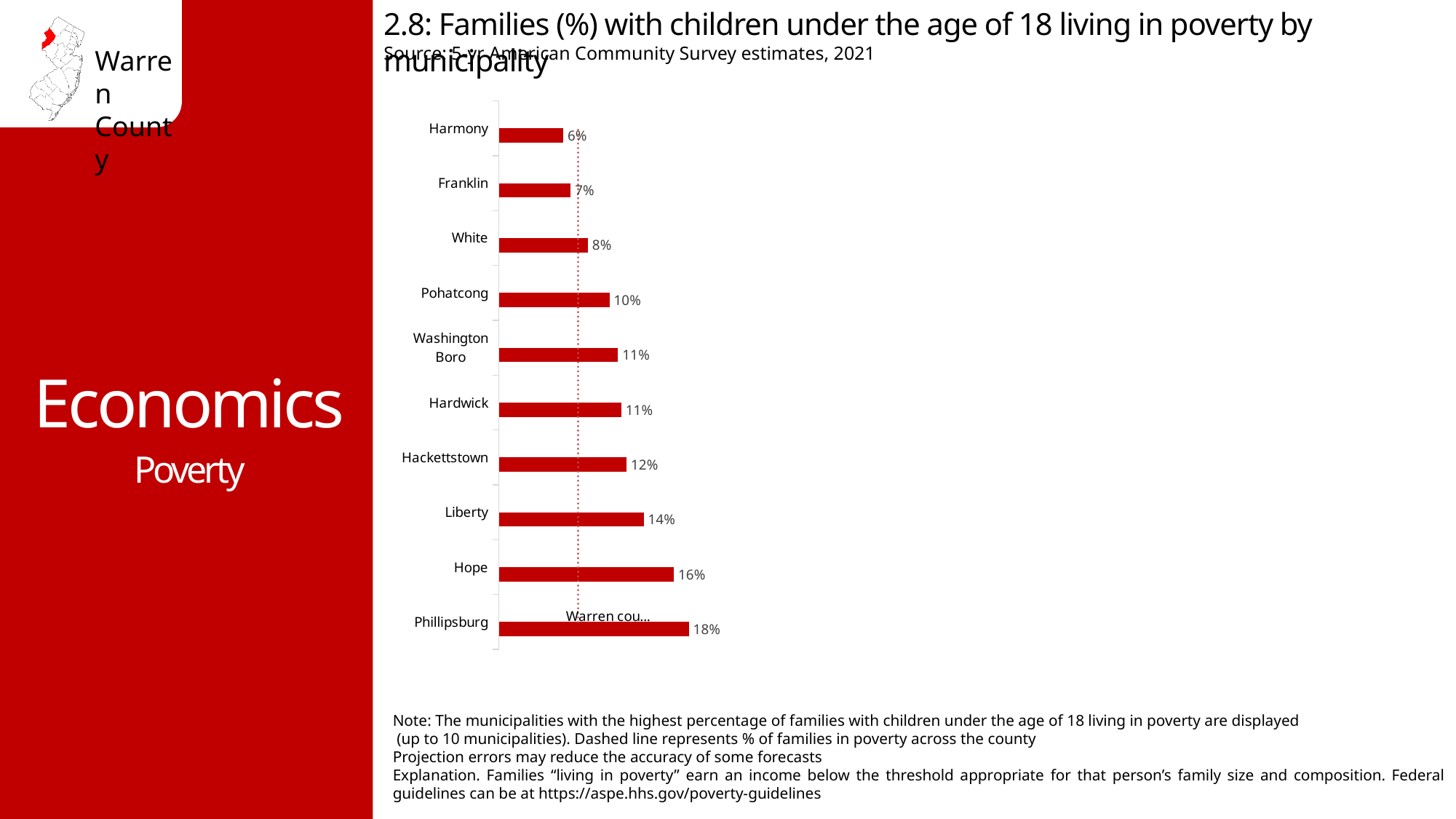
What does the dashed vertical line on the chart represent? % of families in poverty across the county Which has a higher value, Hackettstown or White? Hackettstown Which municipality has the highest percentage of families with children under 18 living in poverty? Phillipsburg What is the value shown for Pohatcong? 10% What is the value shown for Hope? 16% What is the difference between the values for Liberty and Franklin? 7% What percentage of families with children under 18 are living in poverty in Phillipsburg? 18% Which municipality has the lowest percentage shown on the chart? Harmony How many municipalities are shown on the chart? 10 What is the value shown for Harmony? 6% What type of chart is shown on the slide? Bar chart What is the difference between the values for Phillipsburg and Hope? 2%